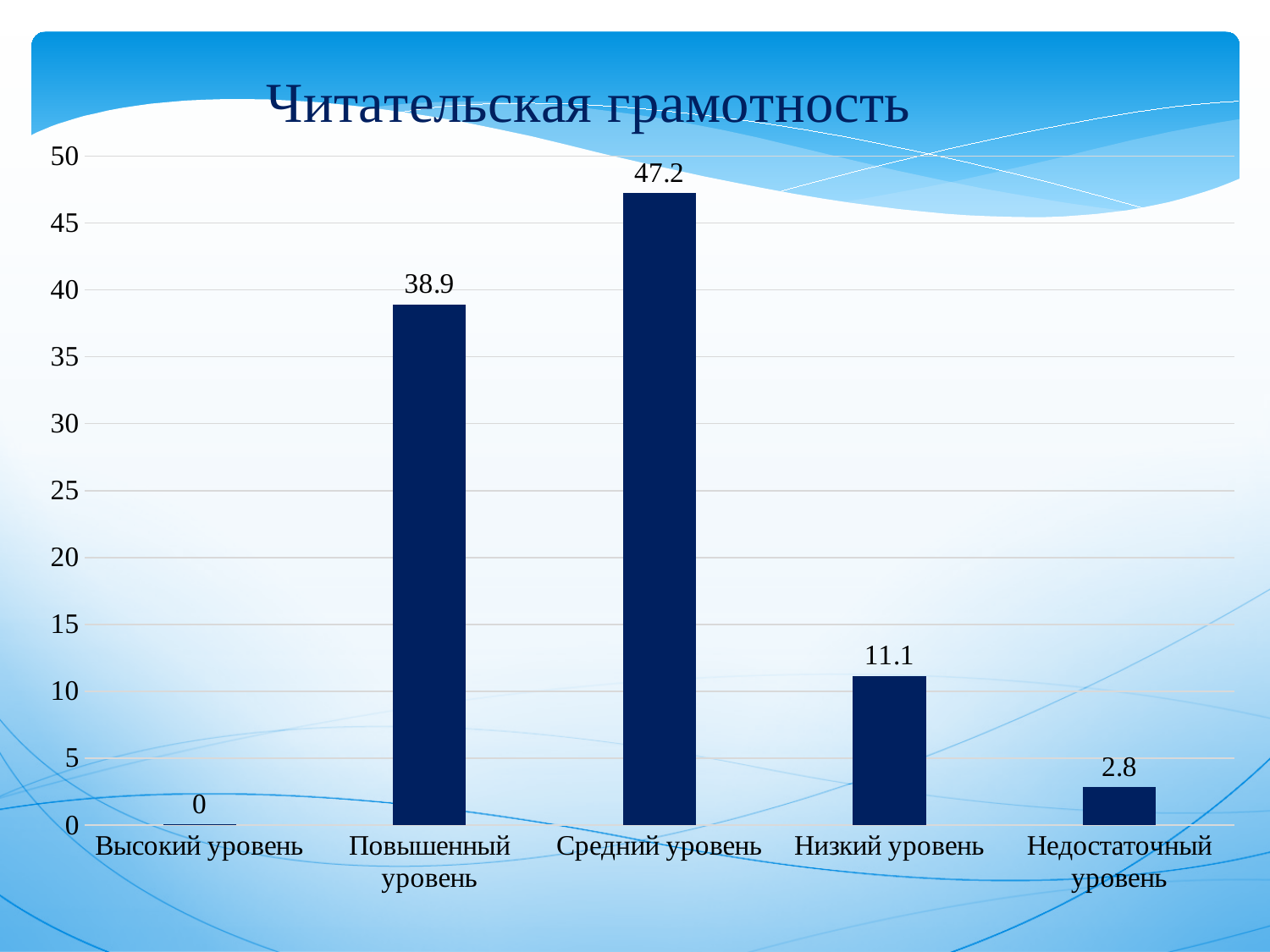
What is the value for Низкий уровень? 11.1 What is the value for Повышенный уровень? 38.9 How many categories are shown on the x axis? 5 What is the title of the chart? Читательская грамотность What is the difference between the values for Средний уровень and Повышенный уровень? 8.3 Which category has the lowest value? Высокий уровень What is the value for Недостаточный уровень? 2.8 What is the value for Высокий уровень? 0 What is the value for Средний уровень? 47.2 Which category has the highest value? Средний уровень Which is larger, the value for Низкий уровень or the value for Недостаточный уровень? Низкий уровень What kind of chart is shown on the slide? Bar chart